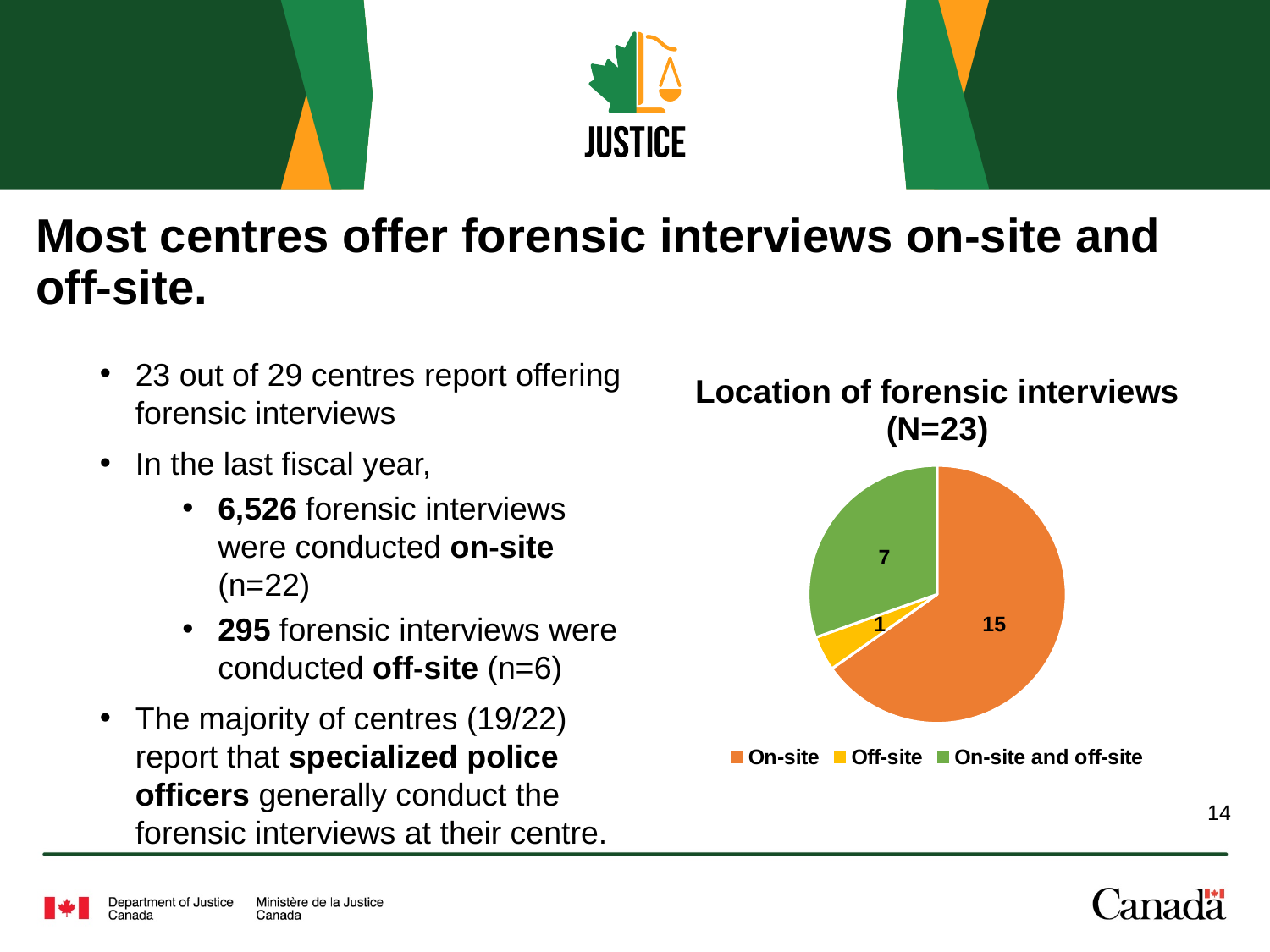
What type of chart is shown on the slide? pie chart How many centres offer forensic interviews on-site only, according to the chart? 15 Which category has the largest slice of the pie? On-site What is the title of the chart? Location of forensic interviews (N=23) What colour is the Off-site slice in the pie chart? yellow How many centres offer forensic interviews off-site only, according to the chart? 1 What share of the pie does the On-site slice represent? 15 out of 23 Which is larger: the On-site and off-site slice or the Off-site slice? On-site and off-site How many categories does the pie chart show? 3 How many centres offer forensic interviews both on-site and off-site, according to the chart? 7 Which category has the smallest slice of the pie? Off-site What is the difference between the On-site value and the On-site and off-site value? 8